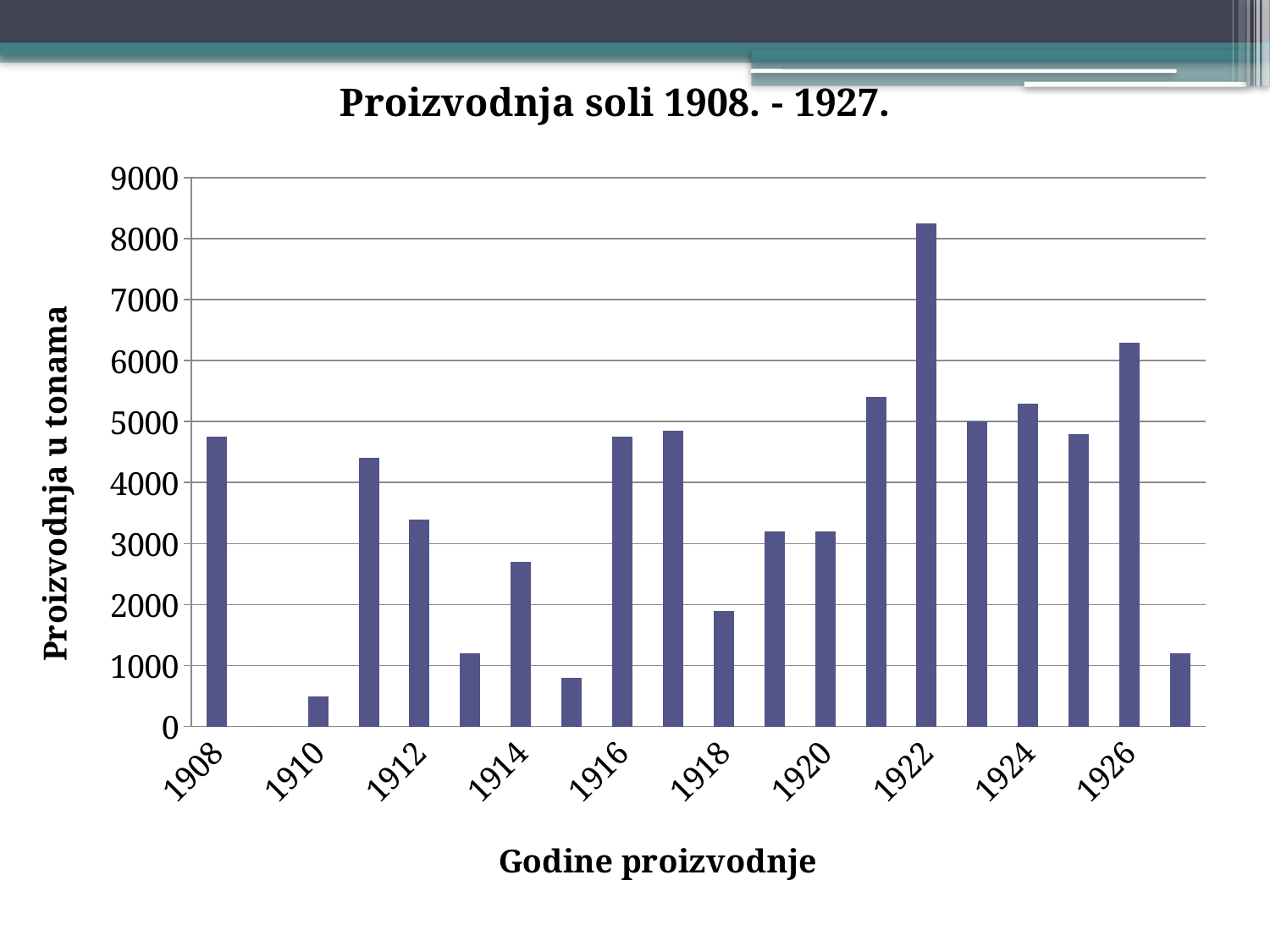
How many year labels are shown on the horizontal axis? 10 Which is larger, the value for 1908 or the value for 1910? 1908 Is the value for 1926 greater or less than 6000? greater Is the value for 1914 greater or less than 3000? less Is the value for 1910 greater or less than 1000? less What is the label of the vertical axis? Proizvodnja u tonama Which year has the highest bar in the chart? 1922 What is the title of the chart? Proizvodnja soli 1908. - 1927. Which is larger, the value for 1922 or the value for 1926? 1922 What kind of chart is shown on the slide? bar chart